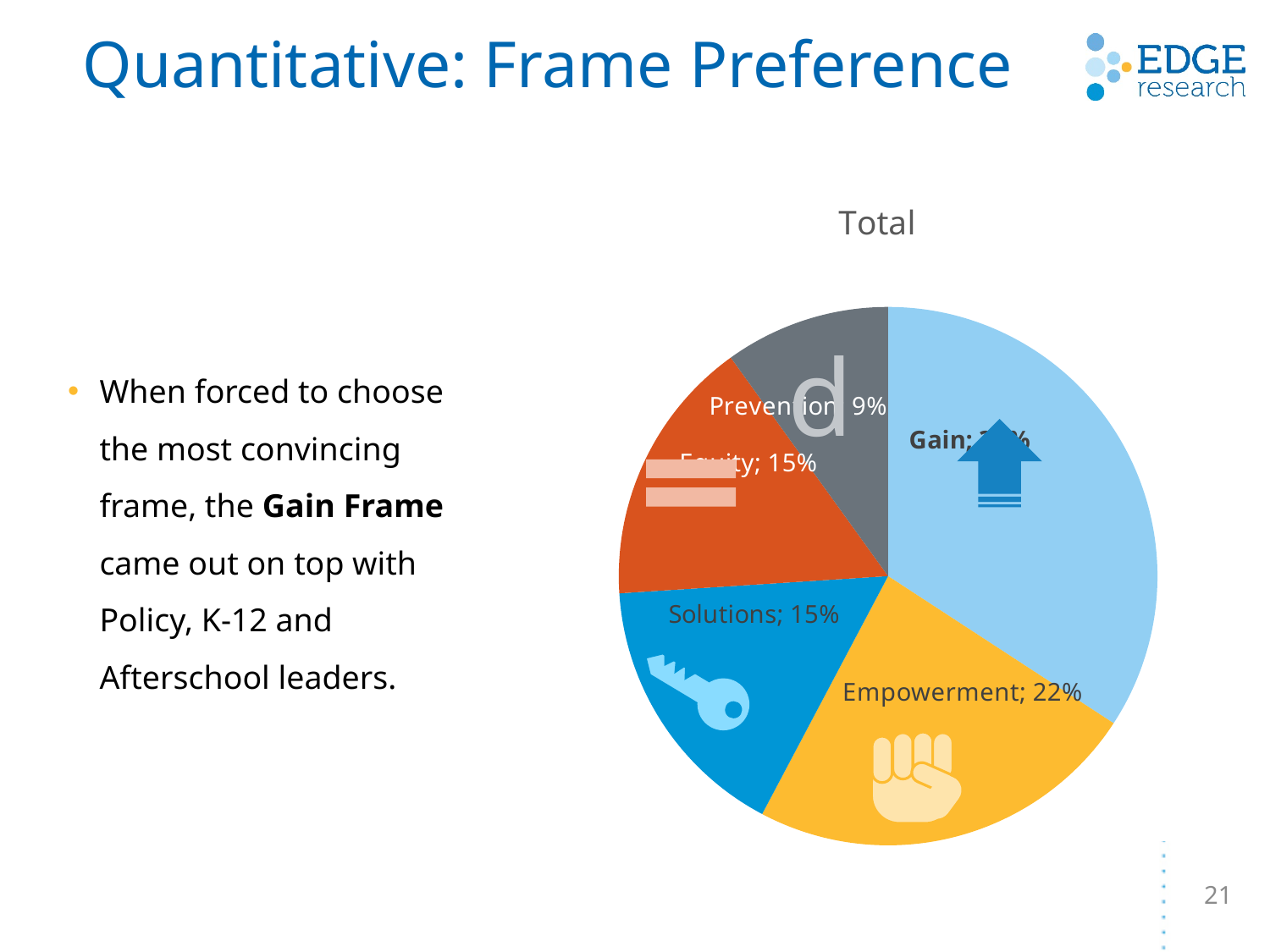
Which is larger, Empowerment or Solutions? Empowerment What is the value shown for Prevention? 9% What kind of chart is shown on the slide? pie chart What is the title of the chart? Total What is the difference in percentage points between Solutions and Prevention? 6 What is the value shown for Solutions? 15% How many slices does the pie chart have? 5 What is the combined share of Empowerment and Solutions? 37% Which slice of the pie is the smallest? Prevention What is the difference in percentage points between Empowerment and Prevention? 13 Which slice of the pie is the largest? Gain What share of the pie does Empowerment represent? 22%